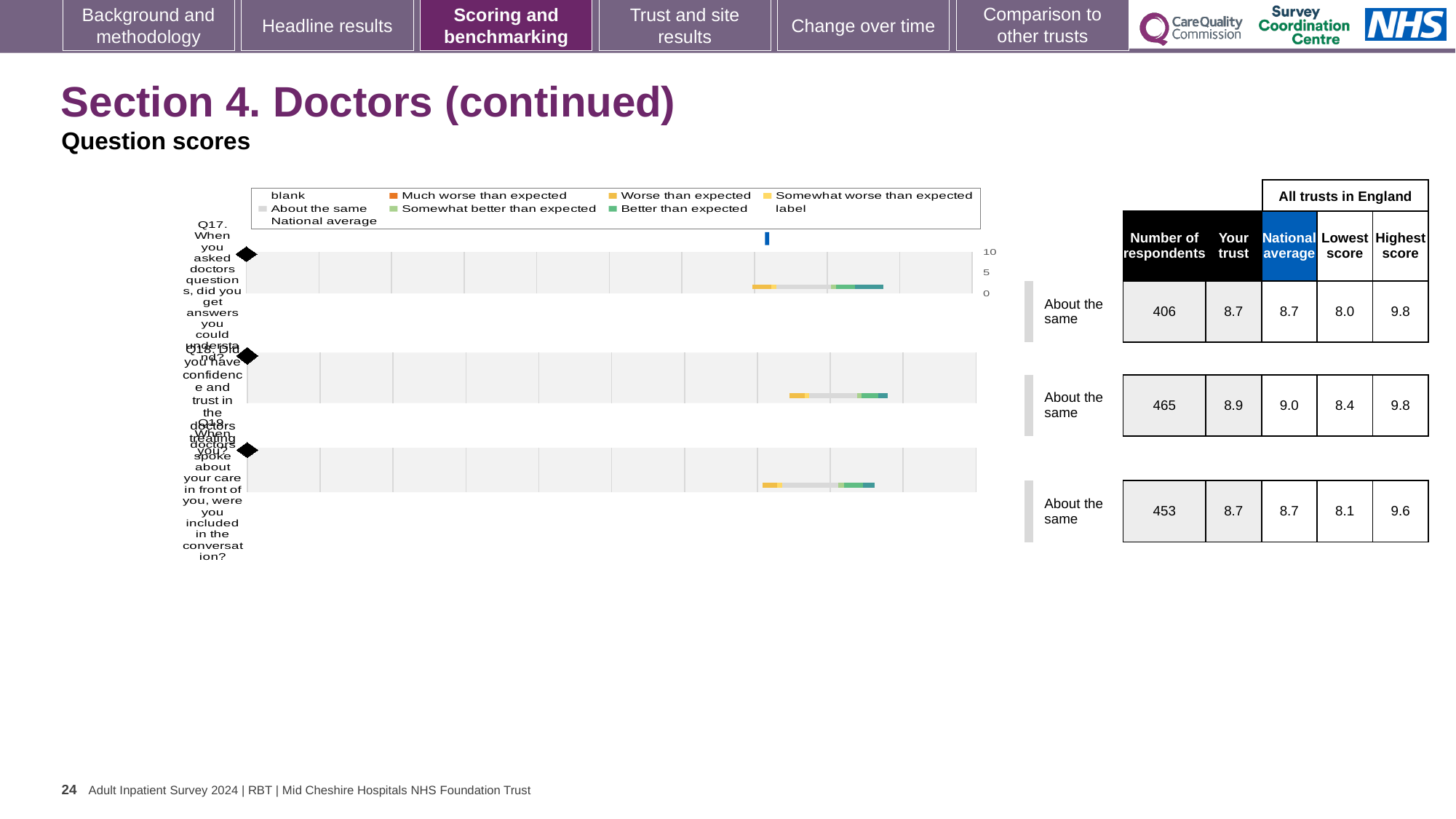
What is the maximum value shown on the chart's score axis? 10 What is the difference between the highest score and the lowest score for Q18? 1.4 For Q18, which is larger: the 'Your trust' score or the national average? National average What kind of chart is shown on the slide? bar chart Which question has the highest 'Your trust' score? Q18 What benchmark category is shown for Q19? About the same What is the number of respondents for Q17? 406 What is the highest score across all trusts in England for Q17? 9.8 What is the national average score for Q19? 8.7 What is the 'Your trust' score for Q18? 8.9 How many questions (categories) are plotted in the chart? 3 What is the lowest score across all trusts in England for Q19? 8.1